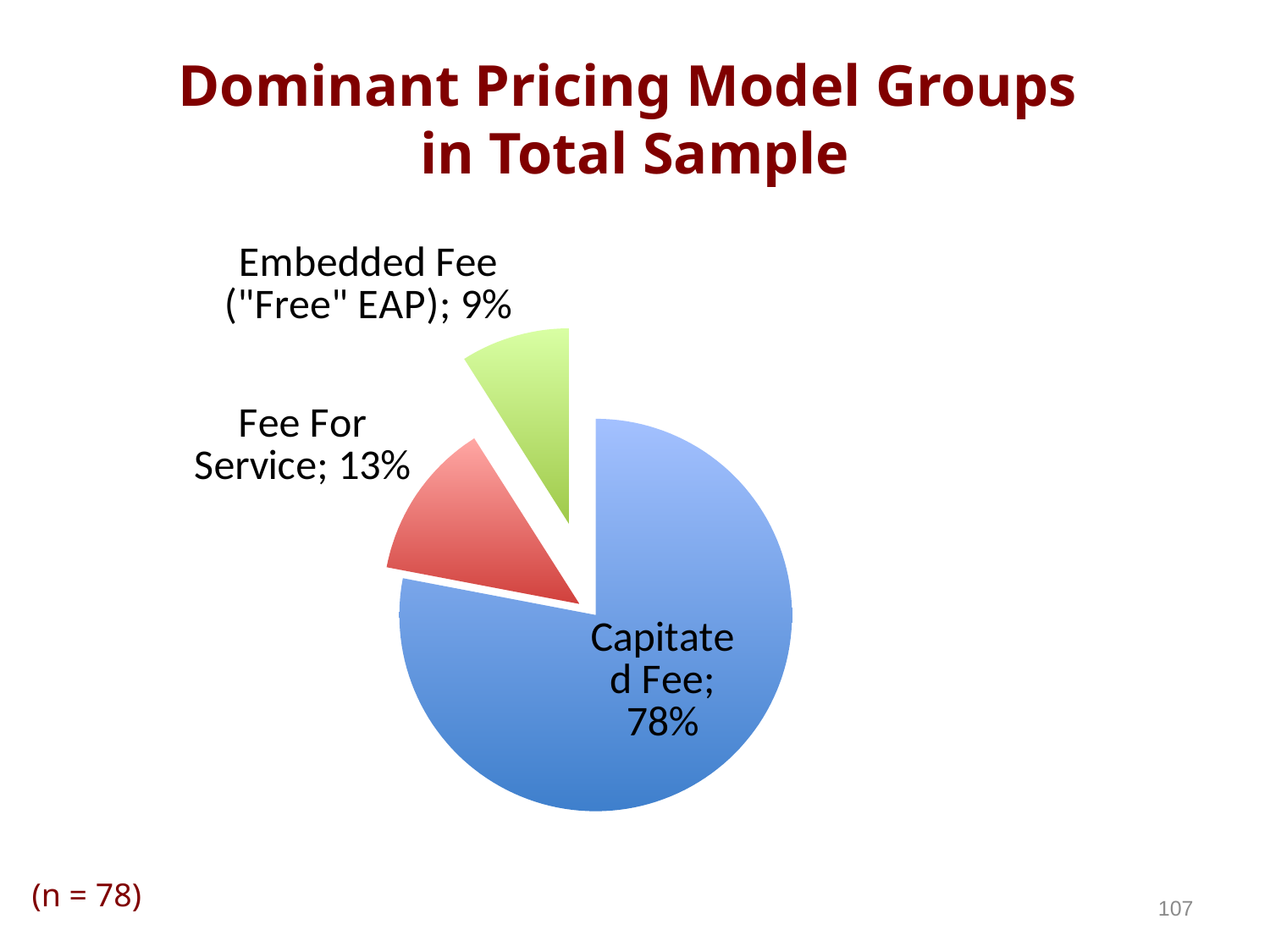
What kind of chart is shown on the slide? Pie chart Which is larger, the share for Fee For Service or the share for Embedded Fee ("Free" EAP)? Fee For Service Which pricing model group has the largest slice of the pie? Capitated Fee What is the title of the chart? Dominant Pricing Model Groups in Total Sample Which pricing model group has the smallest slice of the pie? Embedded Fee ("Free" EAP) What is the sample size (n) noted on the slide? 78 What share of the pie does Capitated Fee represent? 78% What is the difference in percentage points between Fee For Service and Embedded Fee ("Free" EAP)? 4 What is the difference in percentage points between Capitated Fee and Fee For Service? 65 How many slices does the pie chart have? 3 What share of the pie does Embedded Fee ("Free" EAP) represent? 9% What share of the pie does Fee For Service represent? 13%